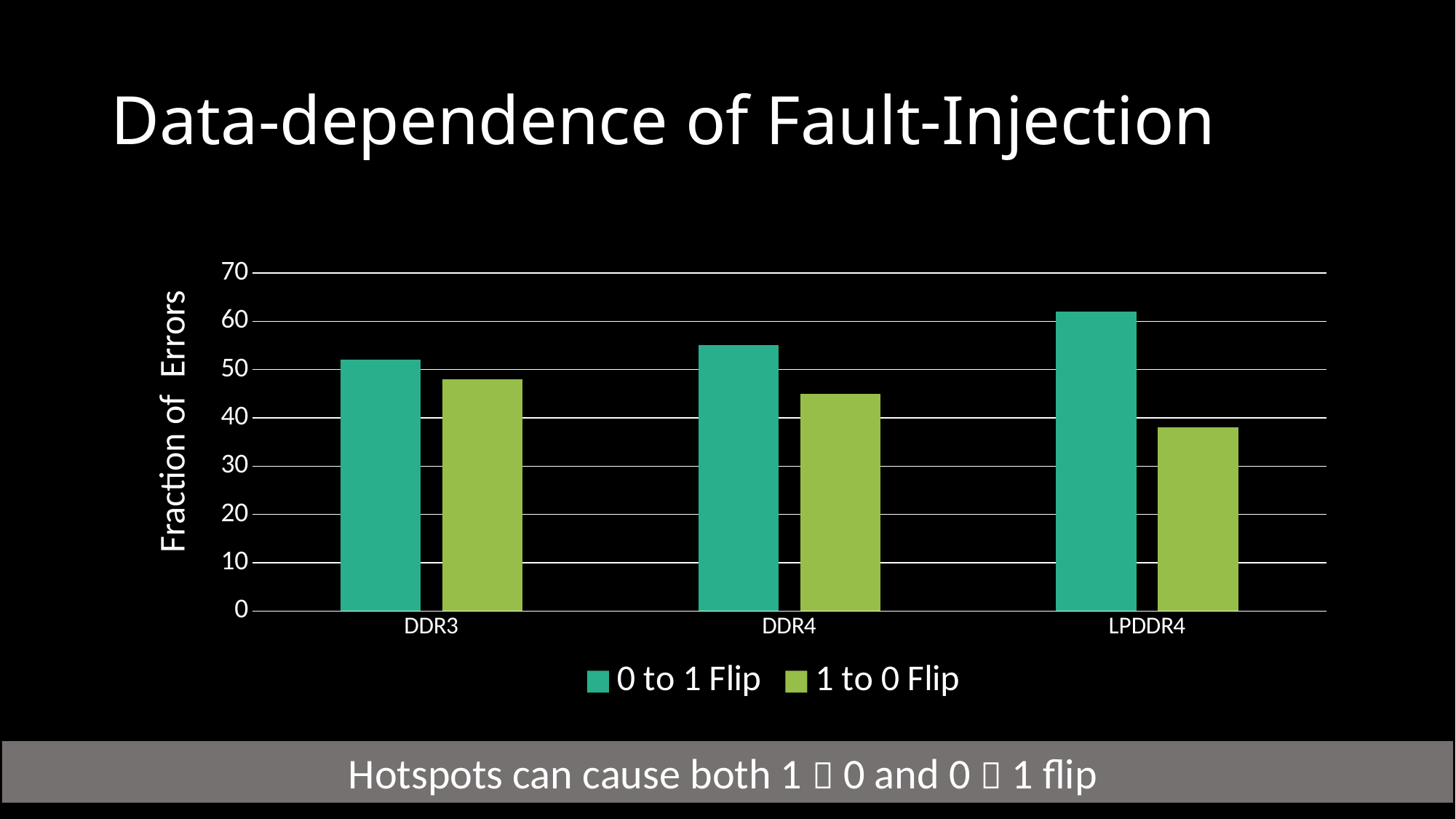
Does the 0 to 1 Flip series rise or fall going from DDR3 to LPDDR4 along the x axis? rise For DDR4, which series has the larger value, 0 to 1 Flip or 1 to 0 Flip? 0 to 1 Flip Does the 1 to 0 Flip series rise or fall going from DDR3 to LPDDR4 along the x axis? fall What kind of chart is shown on the slide? bar chart How many series does the legend list? 2 What is the label of the y axis? Fraction of Errors Is the 0 to 1 Flip value for DDR4 greater or less than 50? greater Which category has the lowest value for the 1 to 0 Flip series? LPDDR4 Which category has the highest value for the 0 to 1 Flip series? LPDDR4 Is the 1 to 0 Flip value for LPDDR4 greater or less than 50? less For LPDDR4, which series has the larger value, 0 to 1 Flip or 1 to 0 Flip? 0 to 1 Flip How many memory types (categories) are shown on the x axis? 3